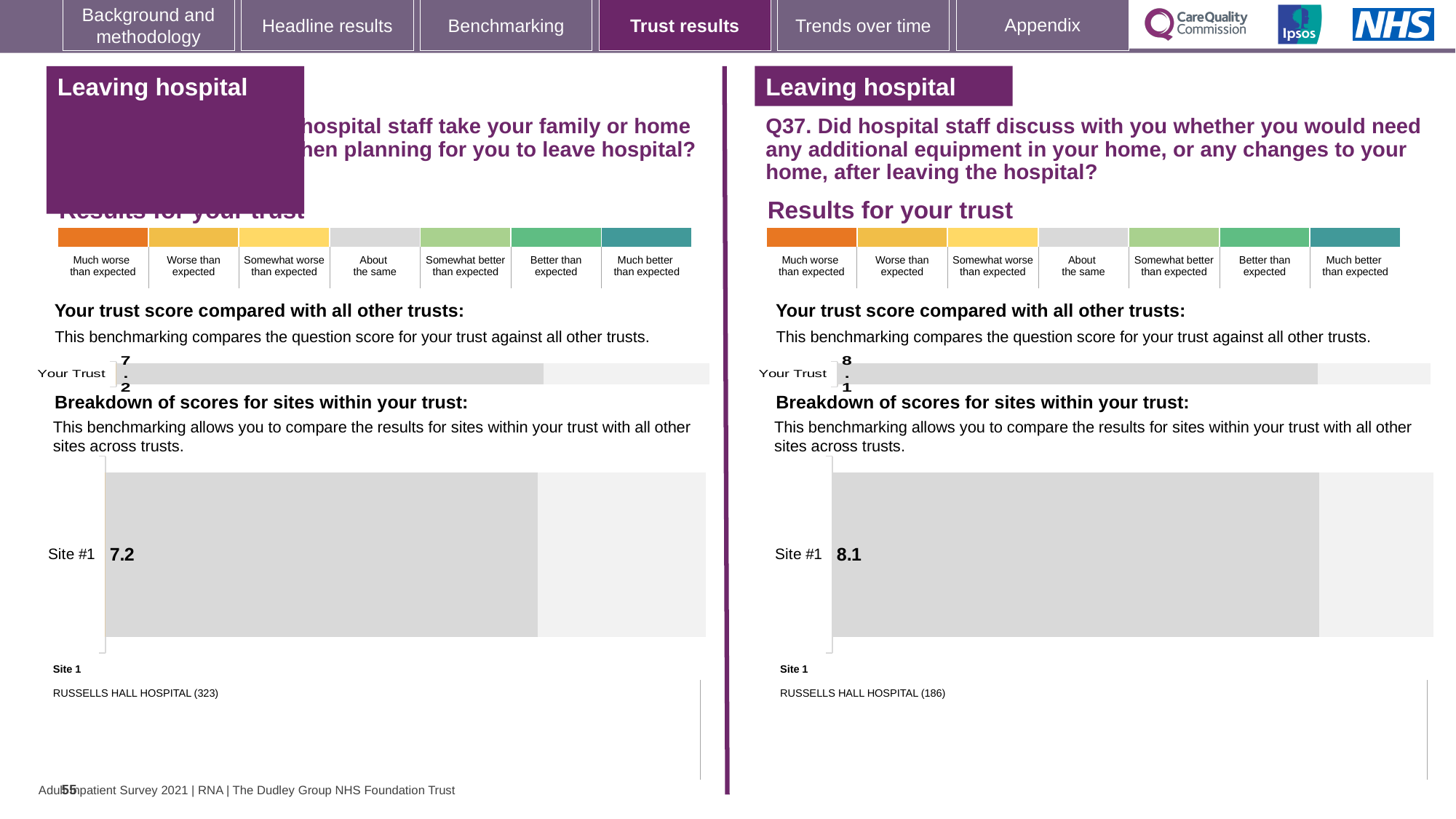
On the right half of the slide (Q37), what is the score shown for Site #1? 8.1 On the left half of the slide, what is the score shown for Site #1? 7.2 How many sites are shown in the site breakdown chart on the left half of the slide? 1 On the left half of the slide, what is the score shown for Your Trust? 7.2 Which site is listed as Site 1 on the right half of the slide (Q37)? RUSSELLS HALL HOSPITAL (186) Which is larger: the Site #1 score on the left half of the slide or the Site #1 score on the right half (Q37)? Site #1 on the right half (Q37) What is the difference between the Site #1 score on the right half (Q37) and the Site #1 score on the left half of the slide? 0.9 On the right half of the slide (Q37), what is the score shown for Your Trust? 8.1 How many sites are shown in the site breakdown chart on the right half of the slide (Q37)? 1 Which site is listed as Site 1 on the left half of the slide? RUSSELLS HALL HOSPITAL (323) What type of chart is used to show the Site #1 score on the right half of the slide (Q37)? Bar chart